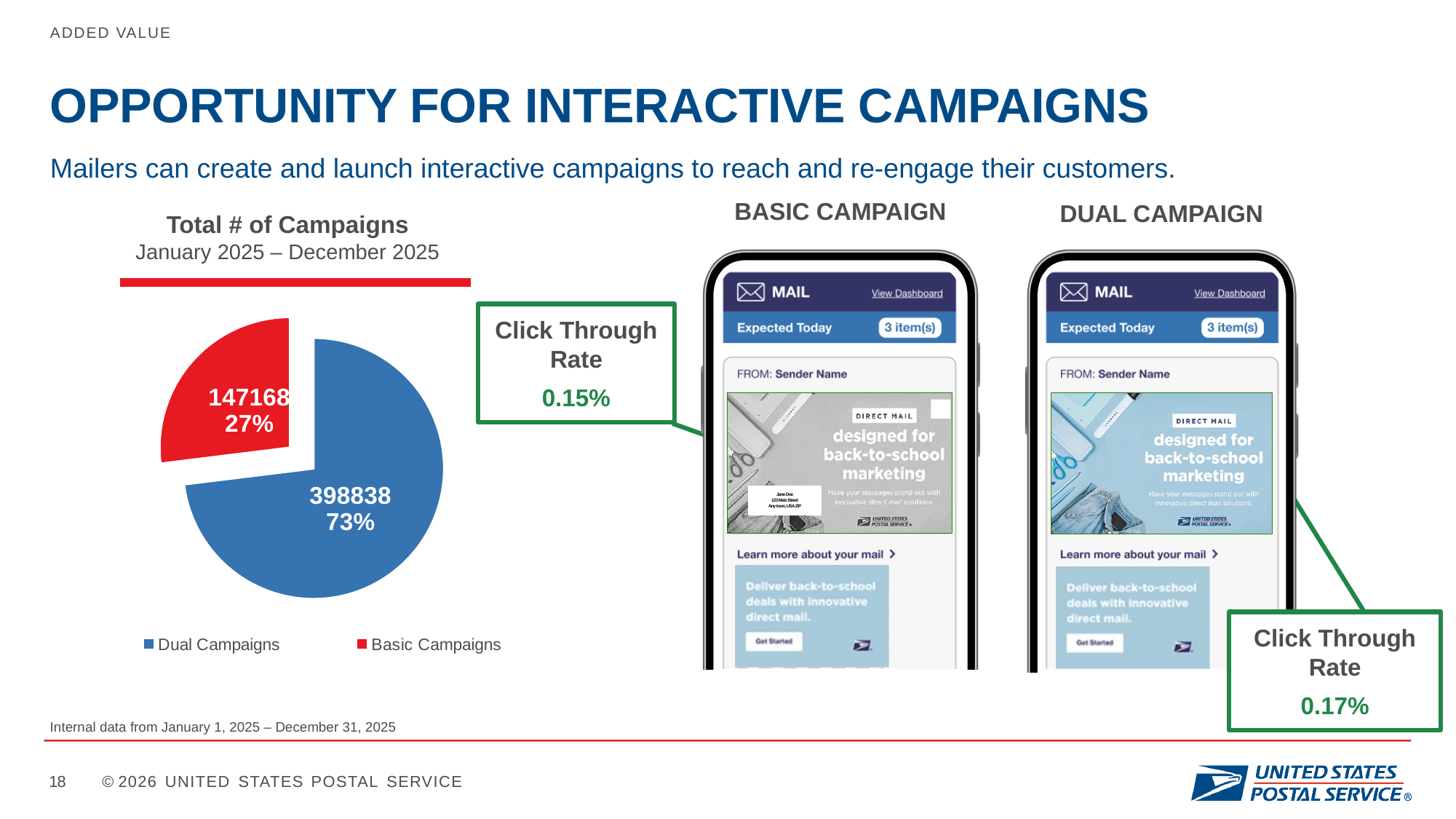
How many campaigns are shown for Dual Campaigns in the pie chart? 398838 How many campaigns are shown for Basic Campaigns in the pie chart? 147168 What time period does the pie chart's subtitle cover? January 2025 – December 2025 What is the difference in the number of campaigns between Dual Campaigns and Basic Campaigns? 251670 Which category has the larger slice in the pie chart? Dual Campaigns What colour is the Basic Campaigns slice in the pie chart? Red What kind of chart is used to show the Total # of Campaigns? Pie chart What is the total number of campaigns across both slices of the pie chart? 546006 What share of the pie chart do Basic Campaigns represent? 27% Which category has the smaller slice in the pie chart? Basic Campaigns How many slices does the pie chart have? 2 What share of the pie chart do Dual Campaigns represent? 73%